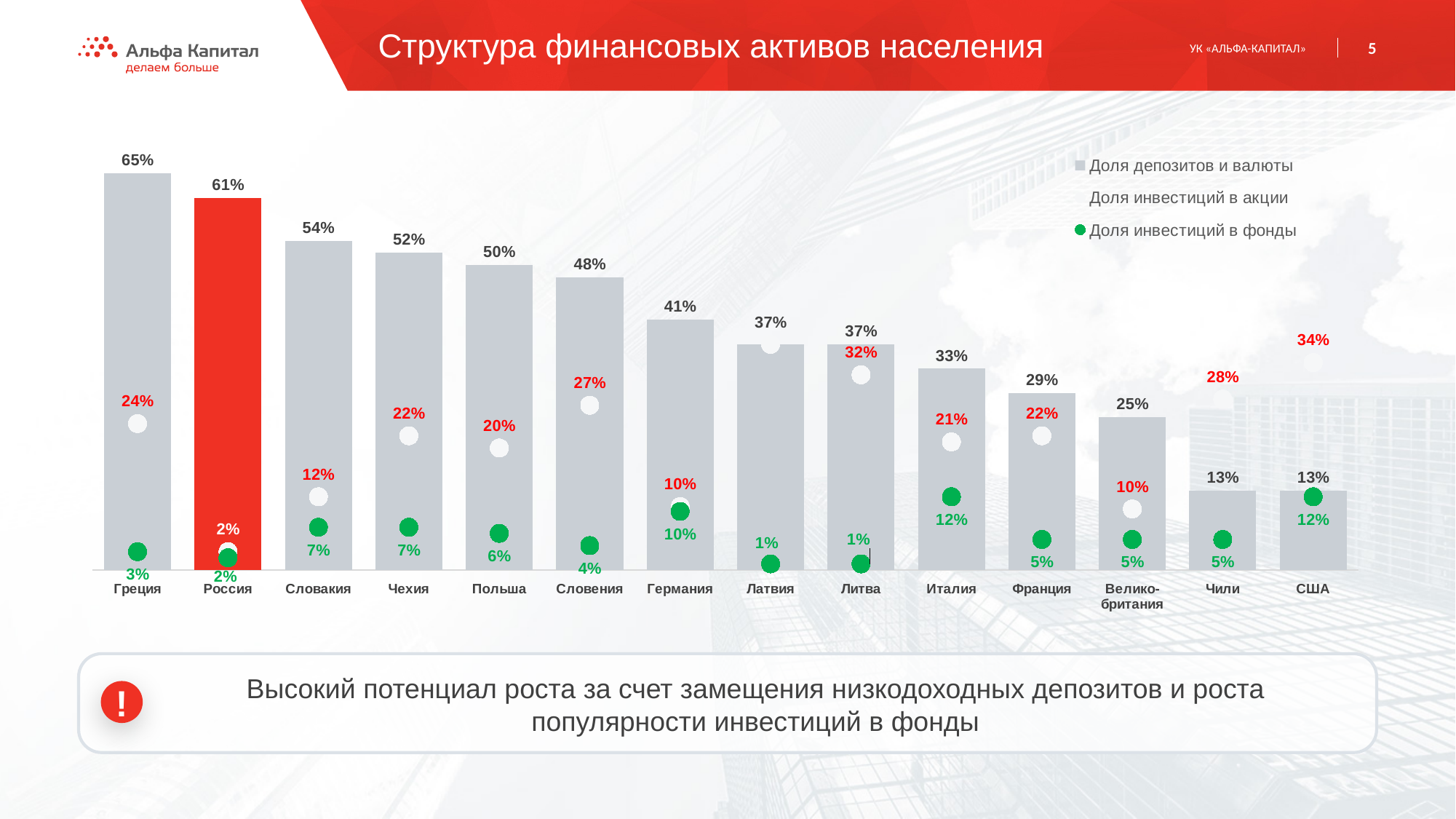
How many series does the legend list? 3 How many countries are shown on the x axis of the chart? 14 Which is larger: the share of investments in funds for Германия or for Франция? Германия What is the difference between the share of deposits and currency for Греция and for Россия? 4% Which country has the highest share of deposits and currency? Греция Do the deposit and currency shares (bars) generally rise or fall from left to right along the x axis? Fall What kind of chart is shown on the slide? Bar chart What is the share of deposits and currency (Доля депозитов и валюты) for Греция? 65% What is the share of investments in stocks (Доля инвестиций в акции) for США? 34% Which country has the highest share of investments in stocks (Доля инвестиций в акции)? Латвия What is the share of investments in funds (Доля инвестиций в фонды) for Италия? 12% What is the share of deposits and currency (Доля депозитов и валюты) for Россия? 61%